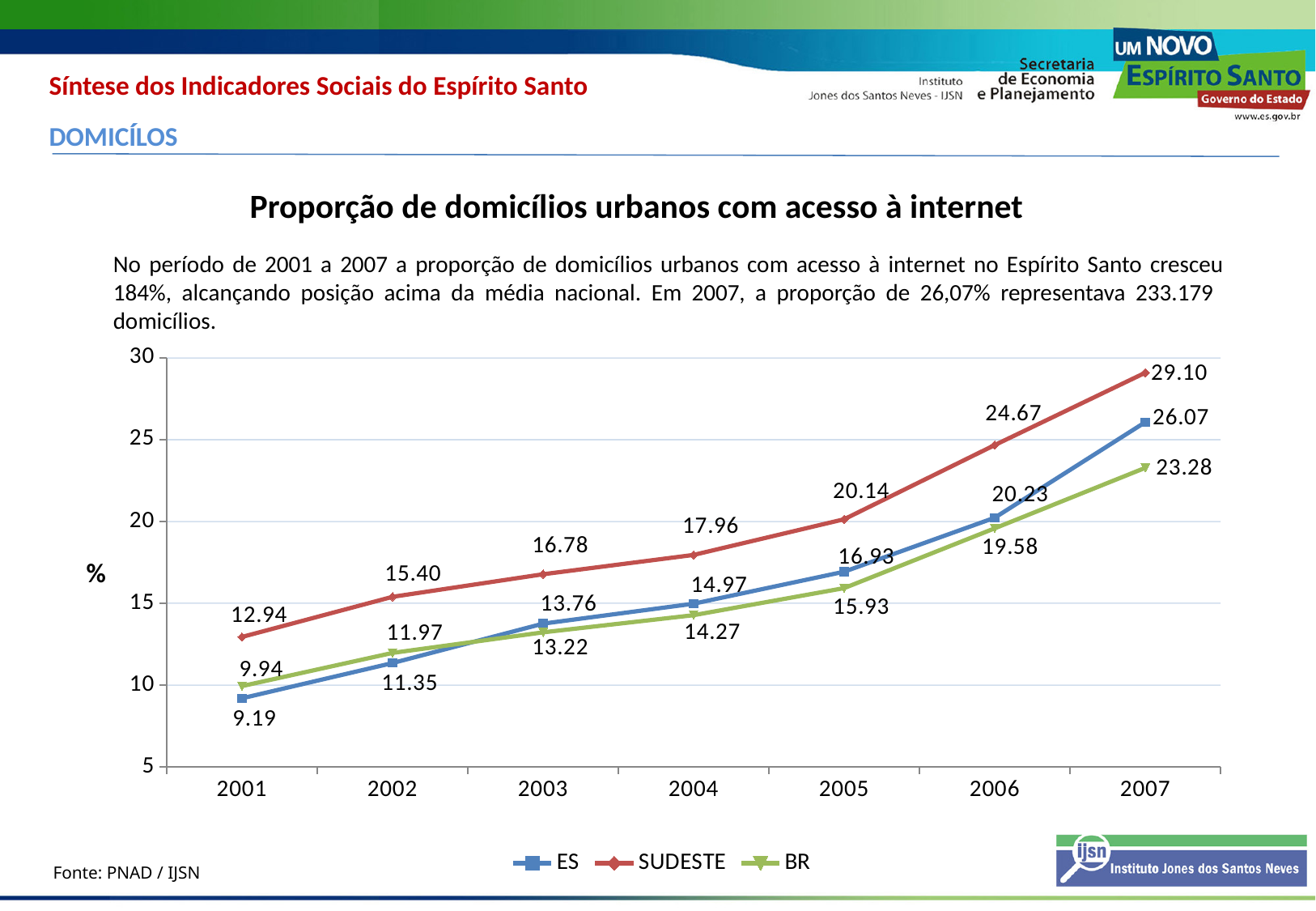
Which is larger in 2003, the ES value or the BR value? ES What type of chart is shown on the slide? line chart What is the title of the chart? Proporção de domicílios urbanos com acesso à internet Do the ES values rise or fall from 2001 to 2007? rise How many years are plotted on the x axis? 7 What is the value for BR in 2001? 9.94 What is the difference between the SUDESTE and ES values in 2007? 3.03 How many series does the legend list? 3 What is the value for SUDESTE in 2004? 17.96 Which series has the highest value in 2007? SUDESTE What is the value for ES in 2007? 26.07 Which series has the lowest value in 2001? ES